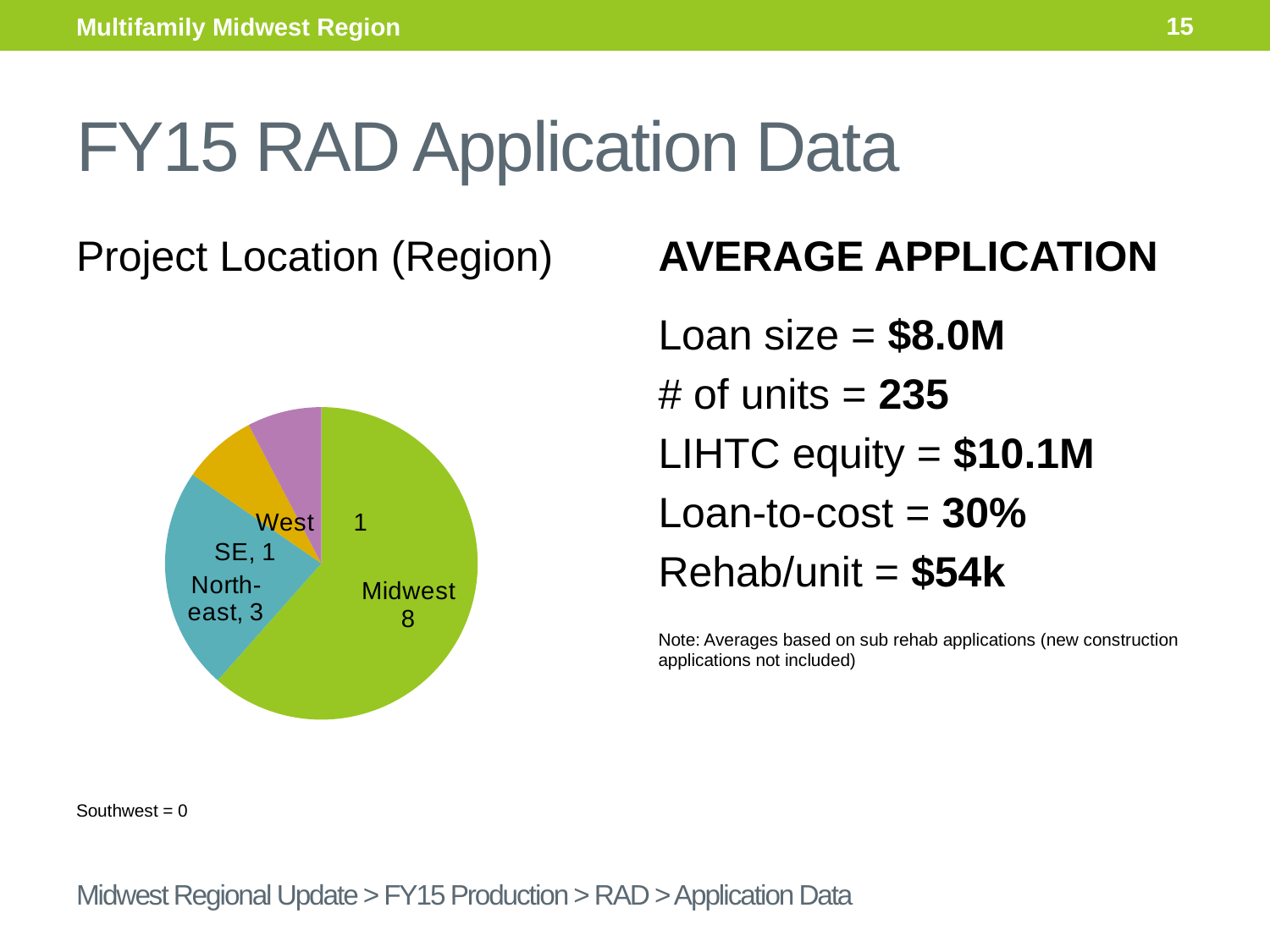
What is the difference between the Midwest and West values in the pie chart? 7 How many slices does the pie chart have? 4 How many applications are from the Midwest region in the pie chart? 8 Which region has the largest slice in the pie chart? Midwest How many applications are from the West region in the pie chart? 1 What is the total of all the slice values in the pie chart? 13 What is the title of the pie chart? Project Location (Region) How many applications are from the Northeast region in the pie chart? 3 What is the difference between the Midwest and Northeast values in the pie chart? 5 How many applications are from the SE region in the pie chart? 1 What type of chart is shown under "Project Location (Region)"? pie chart Which is larger in the pie chart, Northeast or SE? Northeast